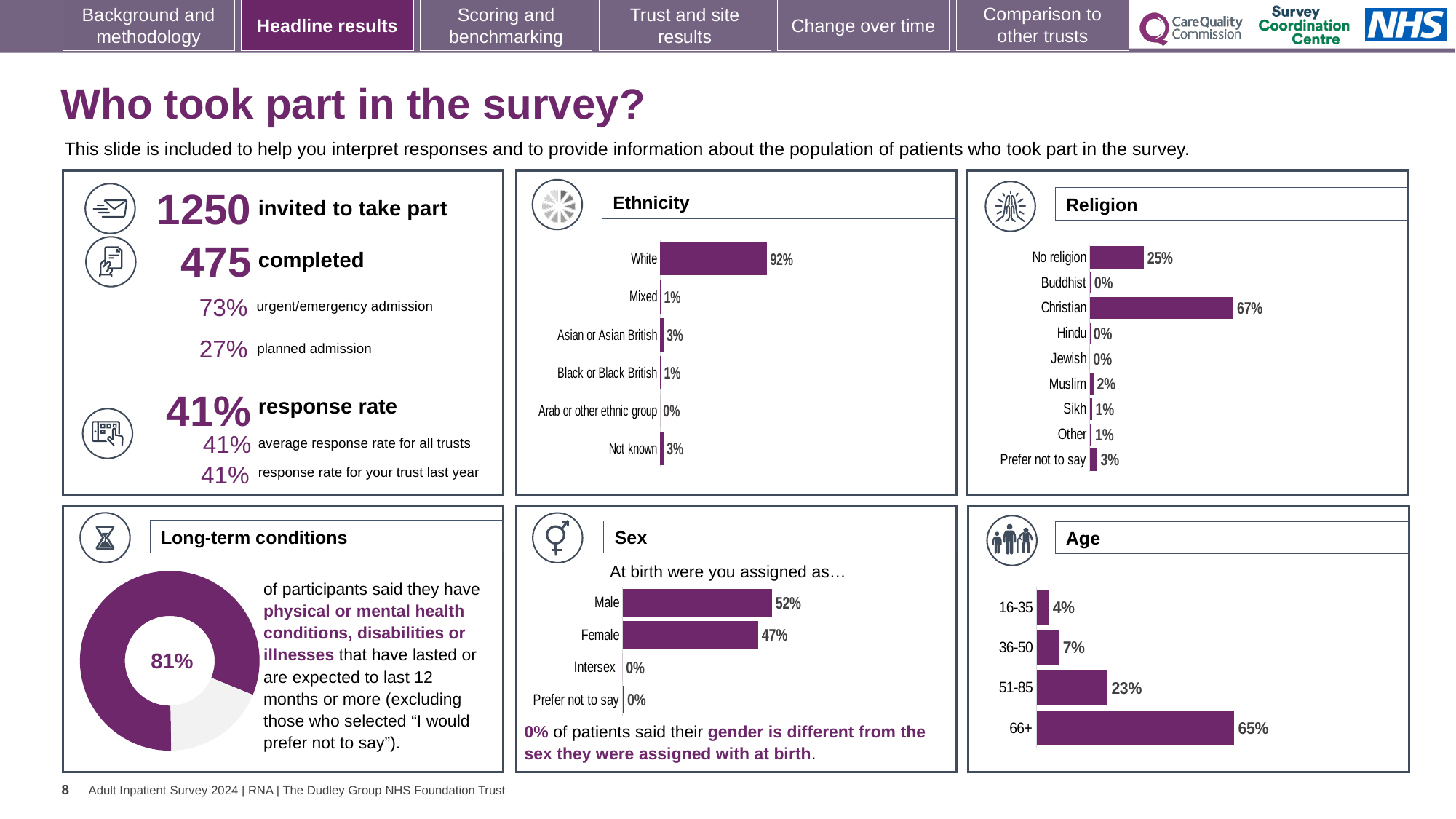
In the Religion chart, what percentage of respondents were Christian? 67% In the Religion chart, what is the difference between the Christian and No religion values? 42% In the Sex chart, which is larger, Male or Female? Male In the Age chart, what percentage of respondents were aged 66+? 65% In the Sex chart, what percentage of respondents were Female? 47% In the Religion chart, how many categories are shown? 9 In the Age chart, do the values rise or fall as age increases from 16-35 to 66+? rise In the Age chart, which age group has the lowest value? 16-35 In the Ethnicity chart, which category has the highest value? White In the Ethnicity chart, how many categories are shown? 6 In the Ethnicity chart, what percentage of respondents were White? 92% What kind of chart is used in the Long-term conditions panel? doughnut chart